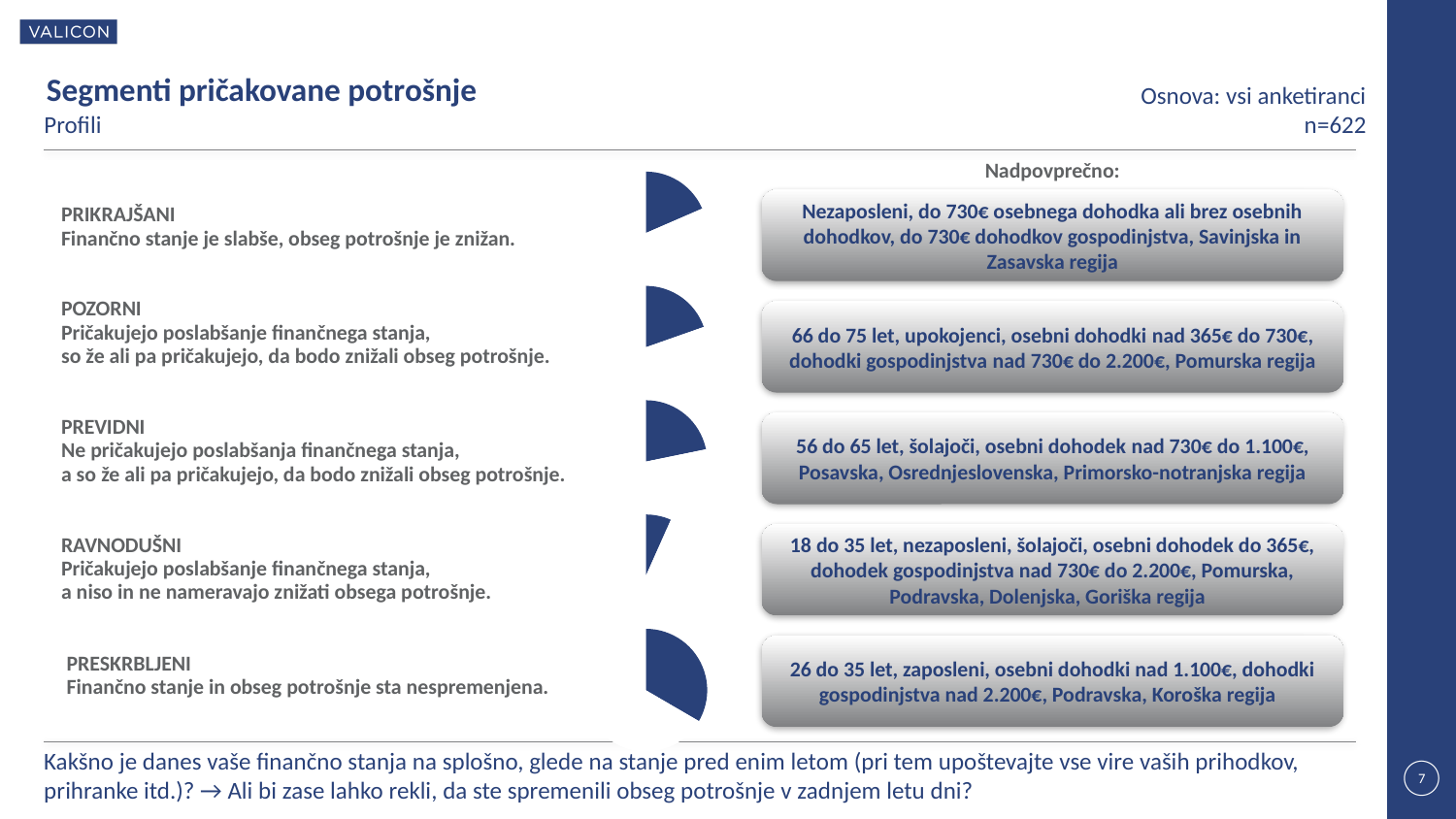
Is the filled slice for PRESKRBLJENI larger or smaller than the filled slice for RAVNODUŠNI? larger What kind of chart is used next to each segment name on the slide? pie chart Which segment's pie chart shows the smallest filled slice? RAVNODUŠNI What is the title of the slide containing the pie charts? Segmenti pričakovane potrošnje Is the filled slice for RAVNODUŠNI larger or smaller than the filled slice for PREVIDNI? smaller What colour are the filled slices in the pie charts? dark blue What sample size (n) is stated on the slide? n=622 How many consumer segments are profiled on the slide? 5 Which segment's pie chart shows the largest filled slice? PRESKRBLJENI How many pie charts are shown on the slide? 5